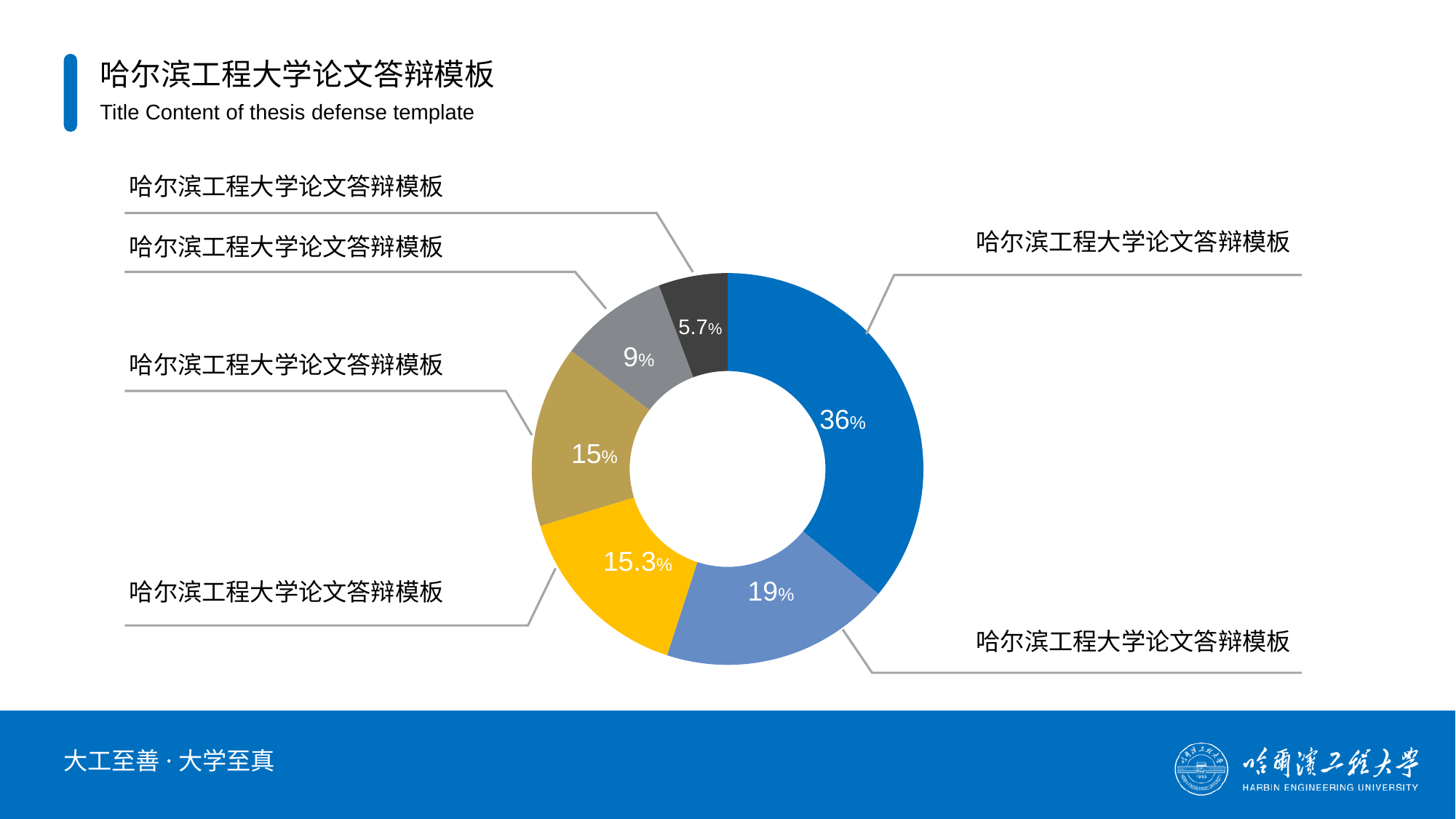
Which slice is larger, the yellow slice or the tan slice? The yellow slice (15.3%) What kind of chart is shown on the slide? Donut (pie) chart What value is labelled on the dark blue slice of the donut chart? 36% What is the difference between the light grey slice (9%) and the dark grey slice (5.7%)? 3.3% What is the smallest value shown on the donut chart? 5.7% What is the largest value shown on the donut chart? 36% What is the difference between the largest slice (36%) and the light blue slice (19%)? 17% What value is labelled on the light blue slice of the donut chart? 19% What value is labelled on the light grey slice of the donut chart? 9% What colour is the slice labelled 5.7%? Dark grey What value is labelled on the yellow slice of the donut chart? 15.3% How many slices does the donut chart have? 6